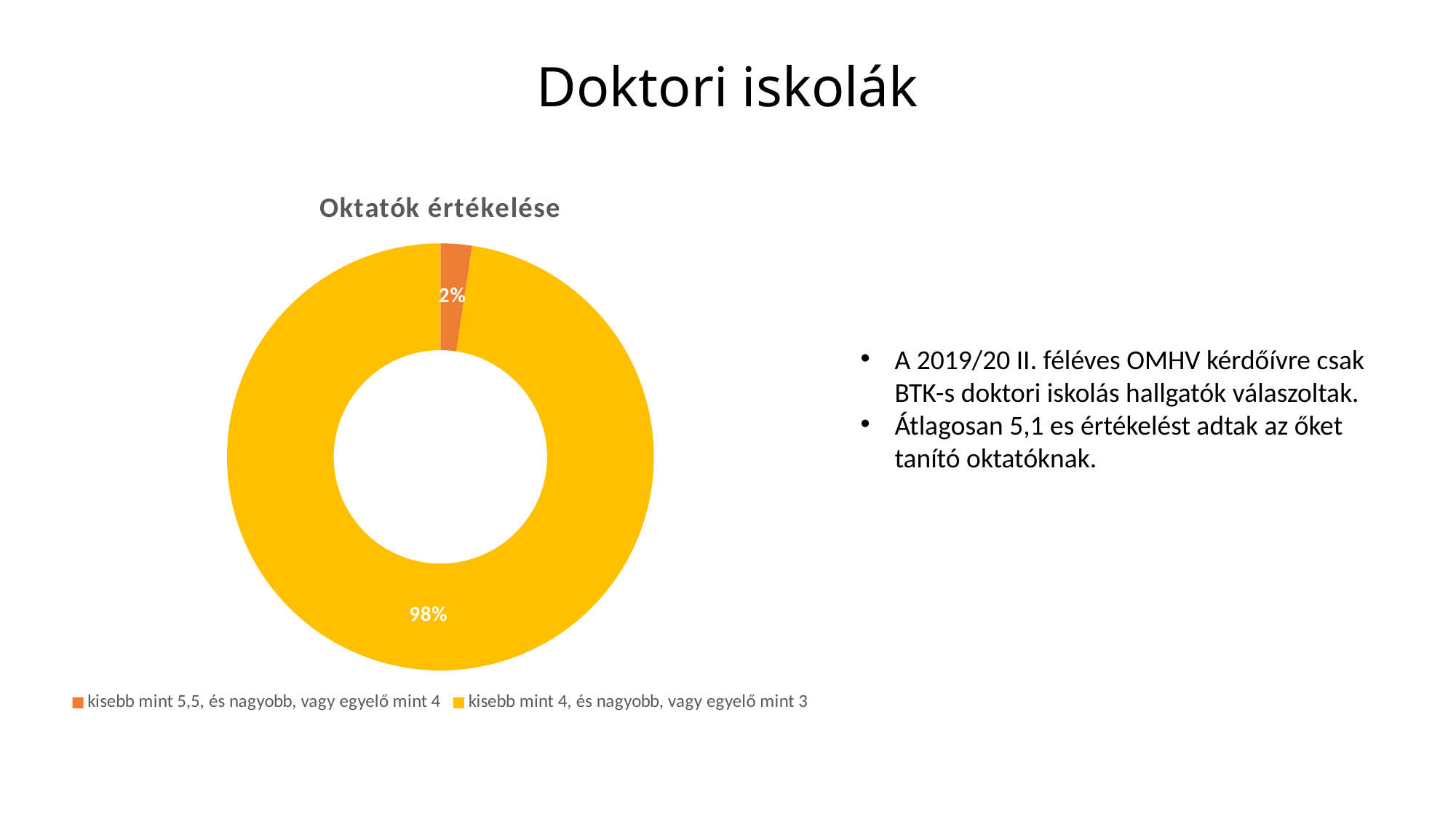
What kind of chart is shown on the slide? Doughnut (pie) chart What colour is the slice labelled 98%? Yellow How many entries does the legend list? 2 What is the difference in percentage points between the 98% slice and the 2% slice? 96 percentage points Which category has the largest share of the chart? kisebb mint 4, és nagyobb, vagy egyelő mint 3 What is the share of the chart taken by the orange slice? 2% How many slices does the chart have? 2 Which category has the smallest share of the chart? kisebb mint 5,5, és nagyobb, vagy egyelő mint 4 Which is larger: the share for 'kisebb mint 5,5, és nagyobb, vagy egyelő mint 4' or for 'kisebb mint 4, és nagyobb, vagy egyelő mint 3'? kisebb mint 4, és nagyobb, vagy egyelő mint 3 What percentage is shown for the slice 'kisebb mint 4, és nagyobb, vagy egyelő mint 3'? 98% What percentage is shown for the slice 'kisebb mint 5,5, és nagyobb, vagy egyelő mint 4'? 2% What is the title of the chart? Oktatók értékelése